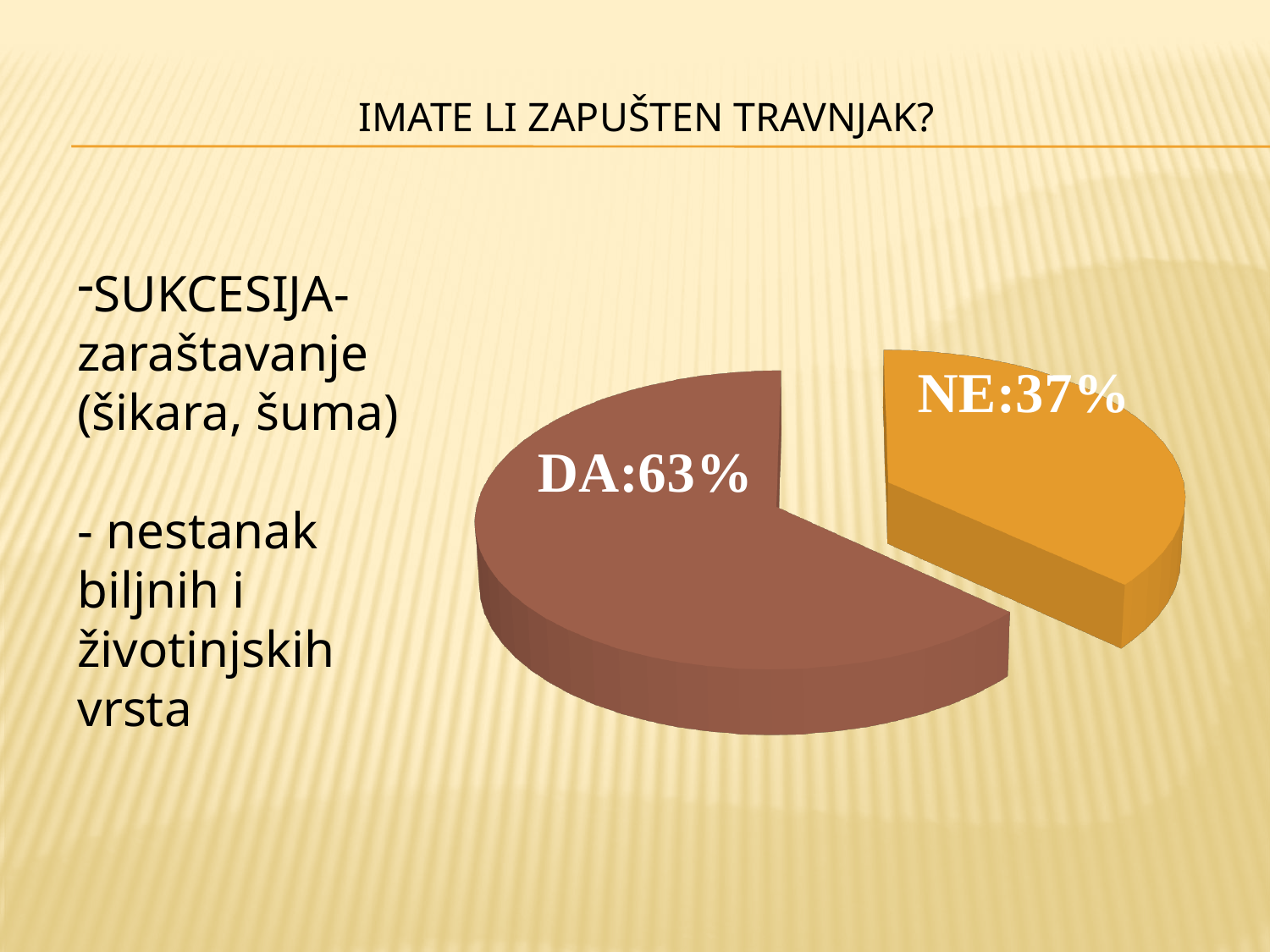
What percentage of the pie is labelled NE? 37% How many slices does the pie chart have? 2 What percentage of the pie is labelled DA? 63% What colour is the DA slice of the pie? brown What kind of chart is shown on the slide? pie chart What is the difference in percentage points between the DA slice and the NE slice? 26 What colour is the NE slice of the pie? orange Which slice of the pie is the smallest? NE Which is larger, the DA slice or the NE slice? DA Which slice of the pie is the largest? DA What share of the pie does the NE slice represent? 37%